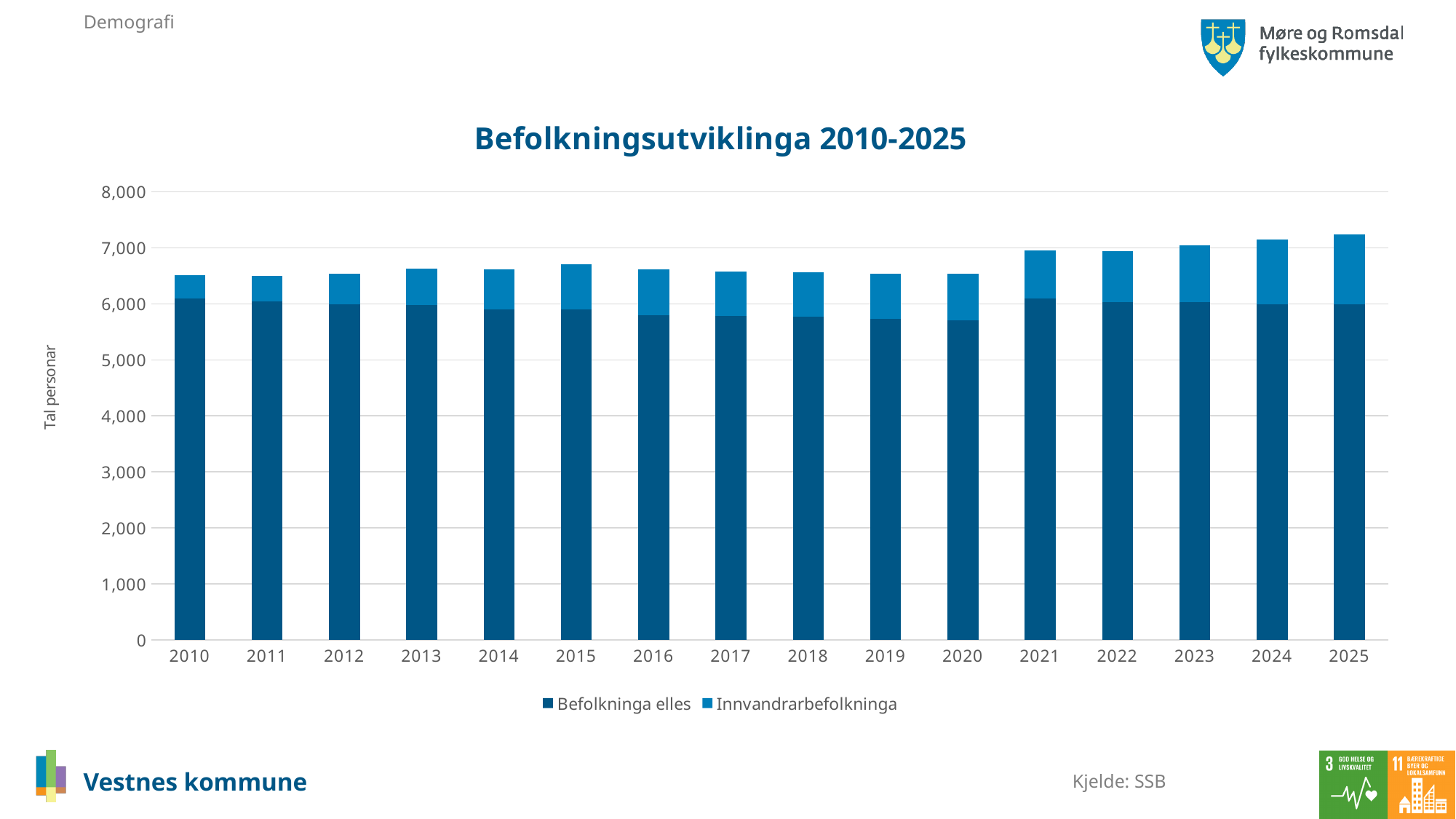
Which year has the larger total bar, 2020 or 2021? 2021 What is the title of the chart? Befolkningsutviklinga 2010-2025 Is the total bar for 2010 greater or less than 7,000? less Is the total bar for 2025 greater or less than 7,000? greater Do the total bars rise or fall from 2020 to 2025? rise How many years are shown on the x axis? 16 How many series does the legend list? 2 Is the Befolkninga elles value for 2020 greater or less than 6,000? less Which year has the largest Innvandrarbefolkninga segment? 2025 Which year has the highest total population bar? 2025 What kind of chart is shown on the slide? Stacked bar chart